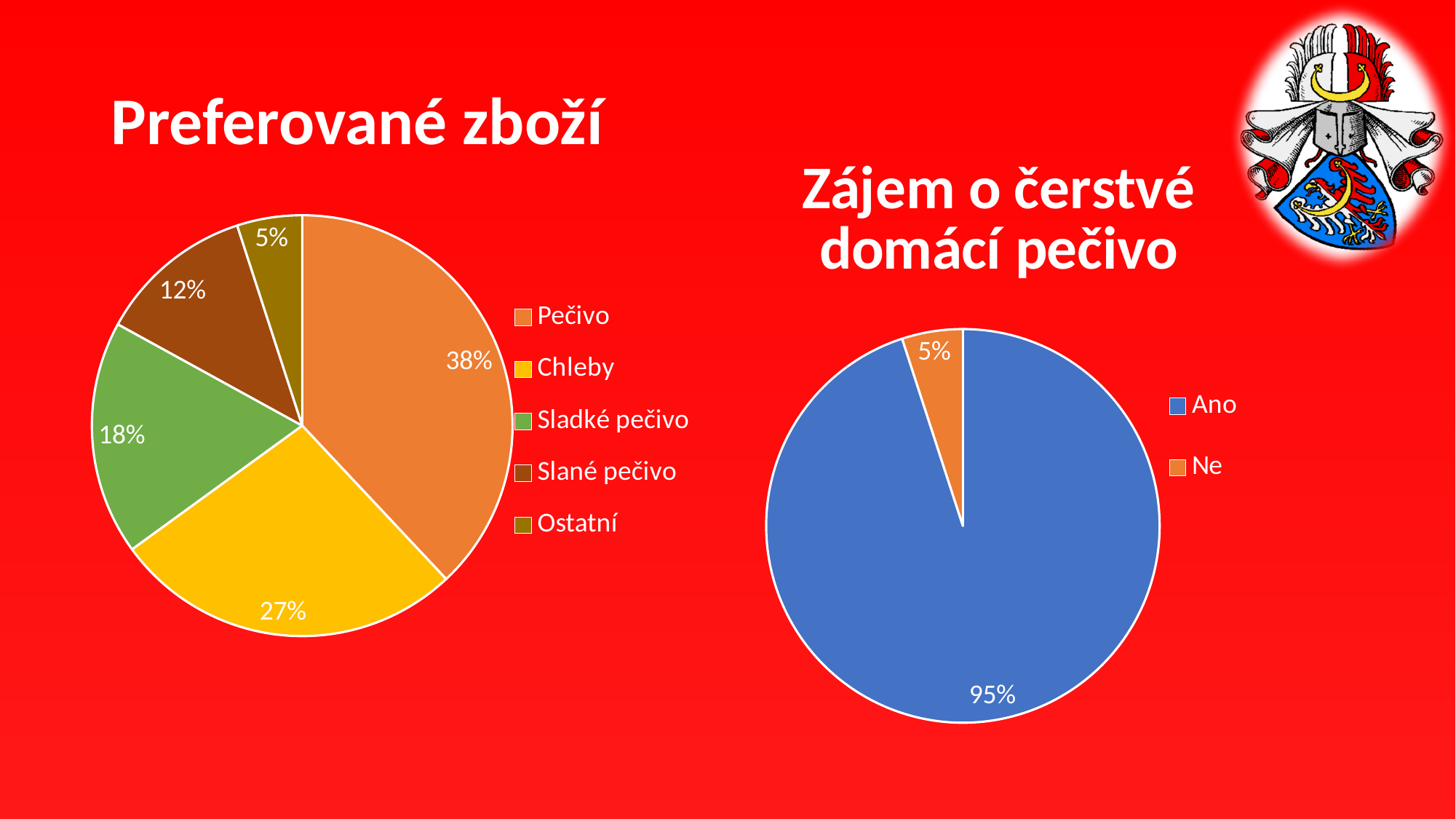
In the 'Preferované zboží' chart, what share does Sladké pečivo have? 18% In the 'Preferované zboží' chart, which category has the smallest share? Ostatní In the 'Zájem o čerstvé domácí pečivo' chart, what is the difference between Ano and Ne? 90% In the 'Preferované zboží' chart, what share does Pečivo have? 38% How many categories does the 'Preferované zboží' chart show? 5 In the 'Preferované zboží' chart, which is larger: Sladké pečivo or Slané pečivo? Sladké pečivo How many entries does the legend of the 'Zájem o čerstvé domácí pečivo' chart list? 2 What kind of chart is 'Zájem o čerstvé domácí pečivo'? Pie chart In the 'Preferované zboží' chart, what is the difference between the shares of Pečivo and Chleby? 11% In the 'Preferované zboží' chart, which category has the largest share? Pečivo In the 'Preferované zboží' chart, what share does Chleby have? 27% In the 'Zájem o čerstvé domácí pečivo' chart, what share does Ano have? 95%